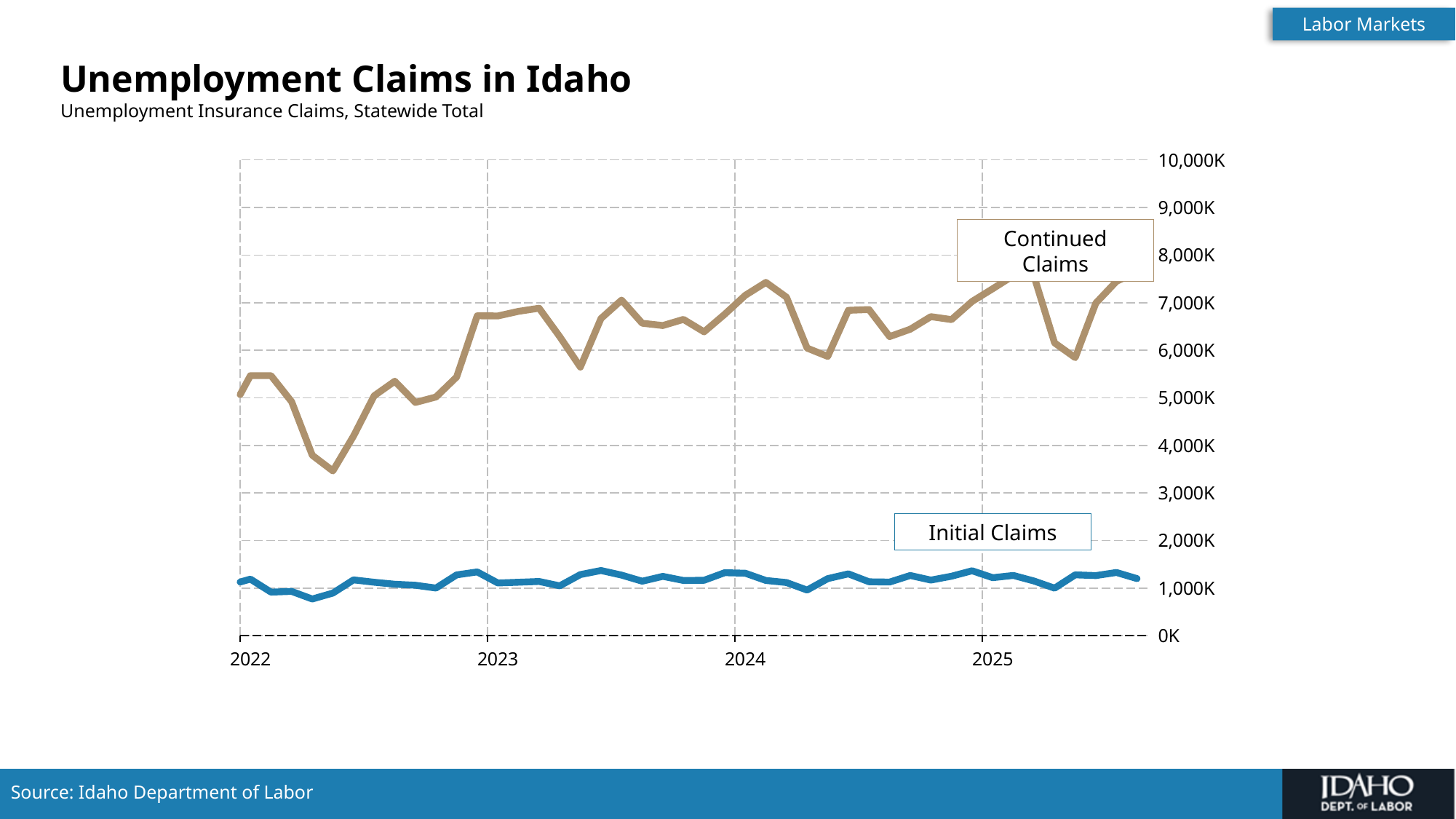
In which year does the Continued Claims line reach its lowest point? 2022 Is the lowest value for Continued Claims during 2022 greater or less than 4,000K? less Do Continued Claims generally rise or fall from 2022 to 2025? rise Is the value for Initial Claims at the start of 2022 greater or less than 2,000K? less Which series has higher values throughout the chart, Continued Claims or Initial Claims? Continued Claims What is the title of the chart on the slide? Unemployment Claims in Idaho How many year labels are shown on the x axis? 4 What kind of chart is shown on the slide? line chart What is the highest value shown on the y axis? 10,000K Is the value for Continued Claims at the start of 2022 greater or less than 4,000K? greater How many series are plotted on the chart? 2